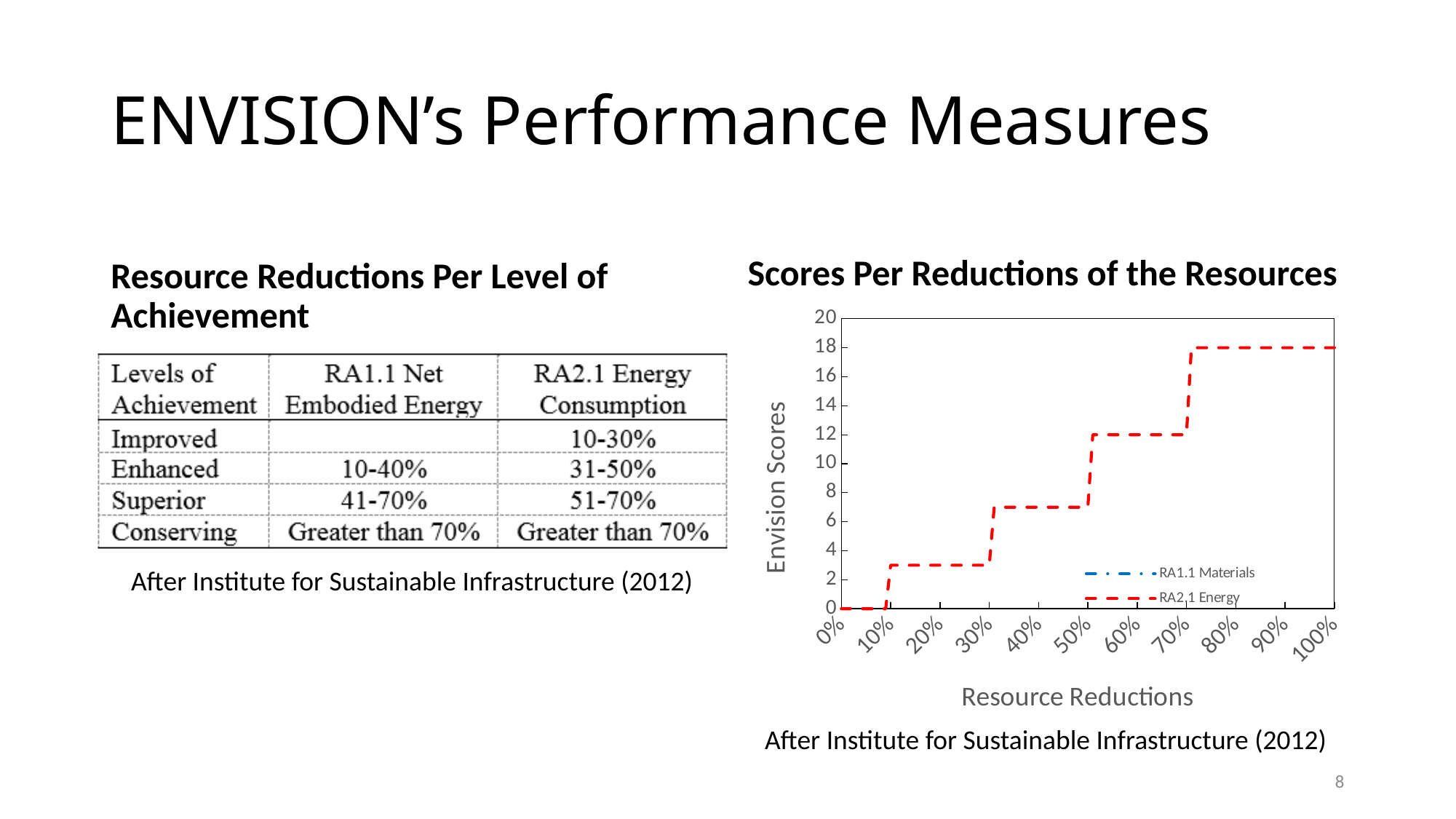
In the "Scores Per Reductions of the Resources" chart, is the RA2.1 Energy score at 60% resource reduction greater or less than 10? greater In the "Scores Per Reductions of the Resources" chart, is the RA2.1 Energy score at 40% resource reduction greater or less than 6? greater In the "Scores Per Reductions of the Resources" chart, is the RA2.1 Energy score larger at 90% or at 40% resource reduction? 90% What is the label on the vertical axis of the "Scores Per Reductions of the Resources" chart? Envision Scores How many tick labels are shown on the x axis of the "Scores Per Reductions of the Resources" chart? 11 In the "Scores Per Reductions of the Resources" chart, do the RA2.1 Energy scores rise or fall as resource reductions increase along the x axis? rise What are the two series named in the legend of the "Scores Per Reductions of the Resources" chart? RA1.1 Materials and RA2,1 Energy In the "Scores Per Reductions of the Resources" chart, is the RA2.1 Energy score at 80% resource reduction greater or less than 16? greater What kind of chart is shown under the title "Scores Per Reductions of the Resources"? line chart In the "Scores Per Reductions of the Resources" chart, what is the highest Envision score reached by the RA2.1 Energy line? 18 How many series does the legend of the "Scores Per Reductions of the Resources" chart list? 2